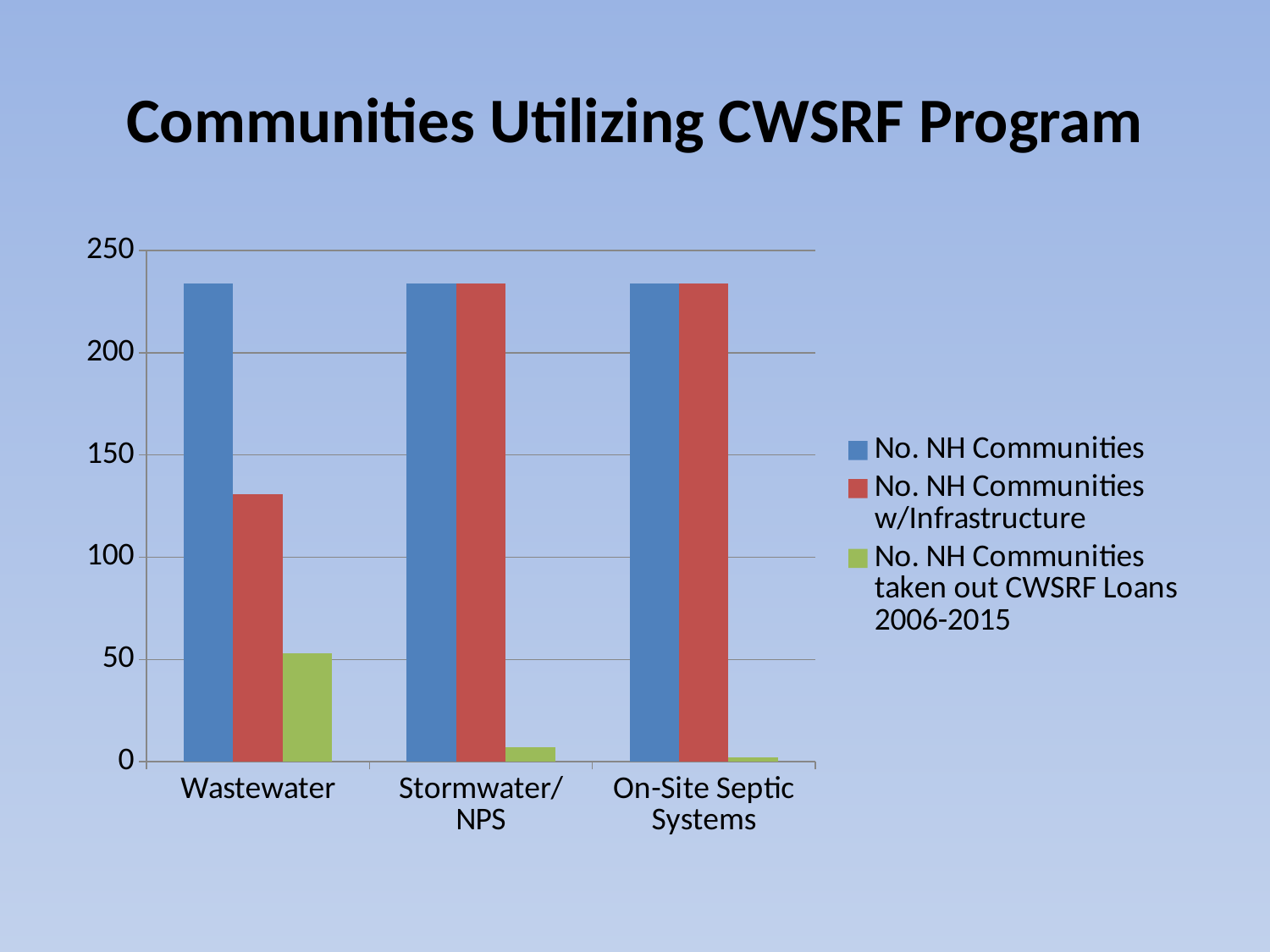
For No. NH Communities w/Infrastructure, which is larger: Wastewater or Stormwater/NPS? Stormwater/NPS Is the value for No. NH Communities w/Infrastructure in the Wastewater category greater or less than 150? less Which colour represents No. NH Communities taken out CWSRF Loans 2006-2015 in the legend? green What kind of chart is shown on the slide? bar chart How many categories are shown on the x axis? 3 What is the title of the chart? Communities Utilizing CWSRF Program Is the value for No. NH Communities taken out CWSRF Loans 2006-2015 in the Stormwater/NPS category greater or less than 50? less Which category has the lowest value for No. NH Communities w/Infrastructure? Wastewater How many series does the legend list? 3 Is the value for No. NH Communities in the Stormwater/NPS category greater or less than 200? greater Which category has the highest value for No. NH Communities taken out CWSRF Loans 2006-2015? Wastewater